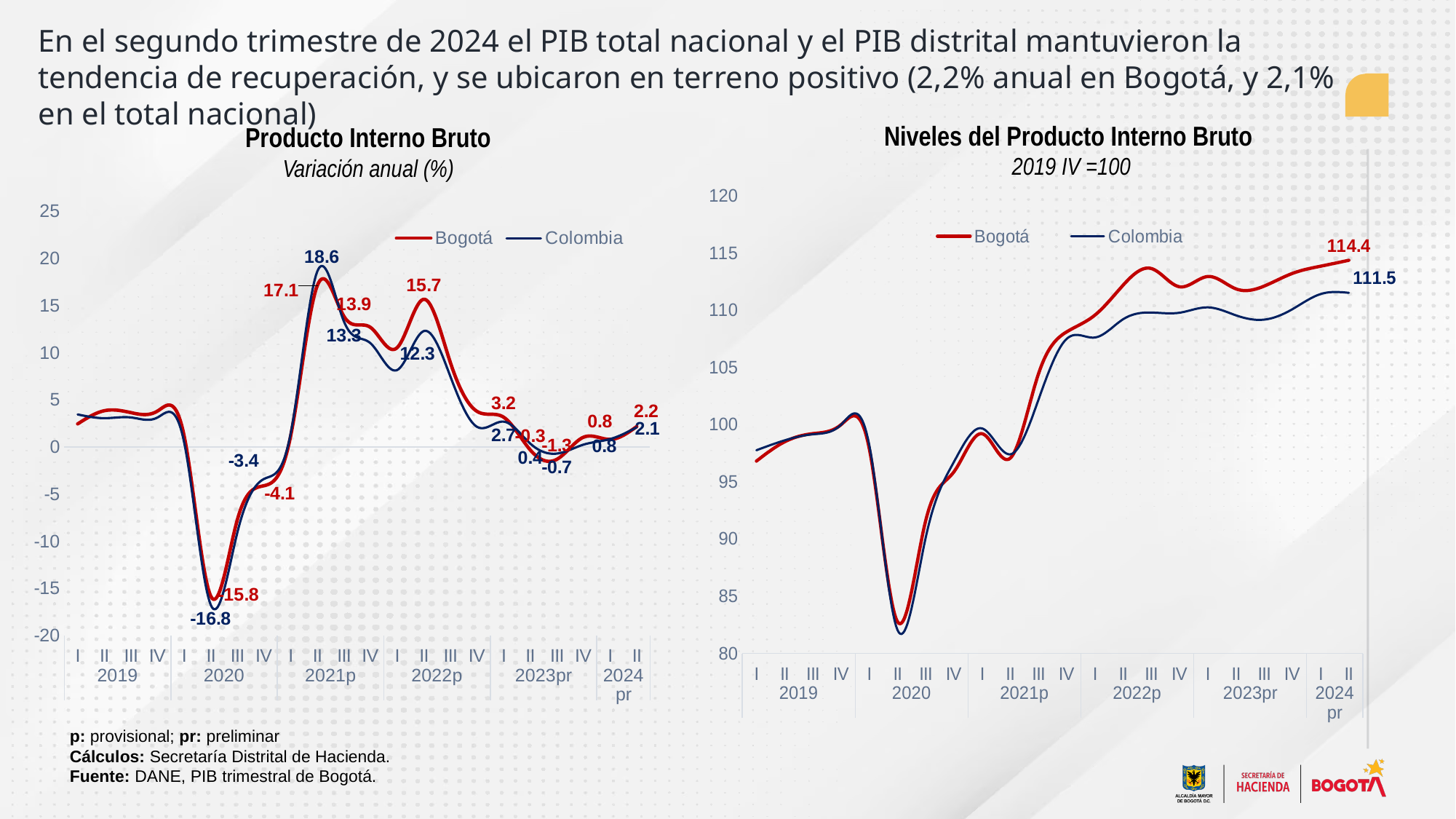
In the 'Producto Interno Bruto' chart, what is the value for Colombia in 2021 II? 18.6 What kind of chart is the 'Producto Interno Bruto' chart on the left? line chart In the 'Producto Interno Bruto' chart, what is the value for Bogotá in 2024 II? 2.2 In the 'Niveles del Producto Interno Bruto' chart, what is the value for Bogotá in 2024 II? 114.4 In the 'Niveles del Producto Interno Bruto' chart, what is the difference between Bogotá and Colombia in 2024 II? 2.9 In the 'Producto Interno Bruto' chart, what is the value for Bogotá in 2020 II? -15.8 In the 'Producto Interno Bruto' chart, what is the difference between Bogotá and Colombia in 2022 II? 3.4 What is the subtitle shown under the title of the 'Niveles del Producto Interno Bruto' chart? 2019 IV =100 In the 'Producto Interno Bruto' chart, what is the value for Colombia in 2024 II? 2.1 How many series does the legend of the 'Niveles del Producto Interno Bruto' chart list? 2 In the 'Producto Interno Bruto' chart, which series reaches the lowest labelled value, and what is it? Colombia, -16.8 In the 'Niveles del Producto Interno Bruto' chart, is the value for Bogotá in 2020 II greater or less than 85? less